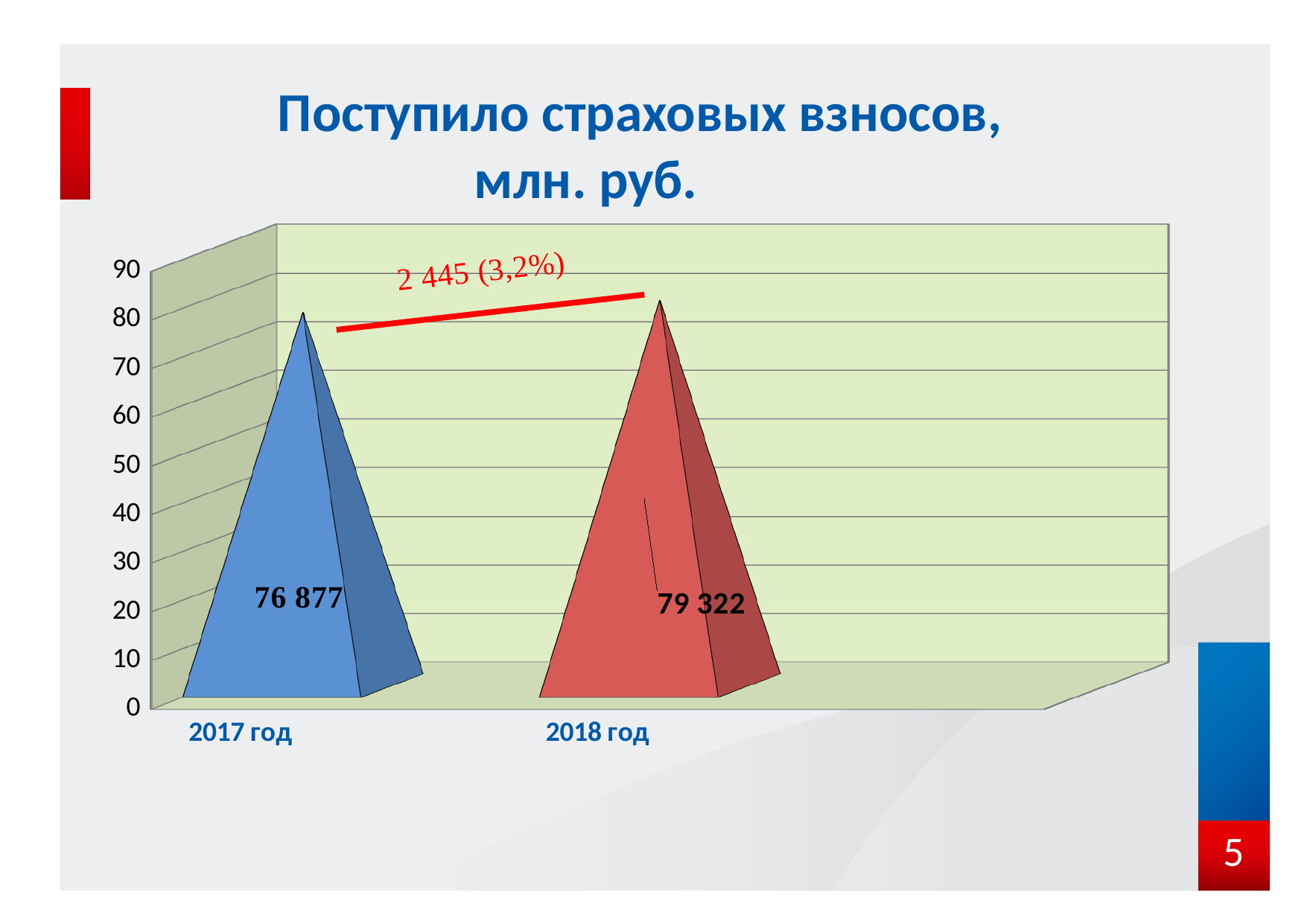
What is the value shown for 2017 год? 76 877 How many categories are shown on the x axis? 2 Which year has the lower value? 2017 год Do the values rise or fall from 2017 год to 2018 год? rise What kind of chart is shown on the slide? bar chart Is the bar for 2018 год greater or less than 90 on the axis? less What is the value shown for 2018 год? 79 322 Is the bar for 2017 год greater or less than 70 on the axis? greater What is the difference between the values for 2018 год and 2017 год? 2 445 What percentage change is written in the red annotation above the bars? 3,2% Is the value for 2018 год larger or smaller than the value for 2017 год? larger Which year has the higher value? 2018 год